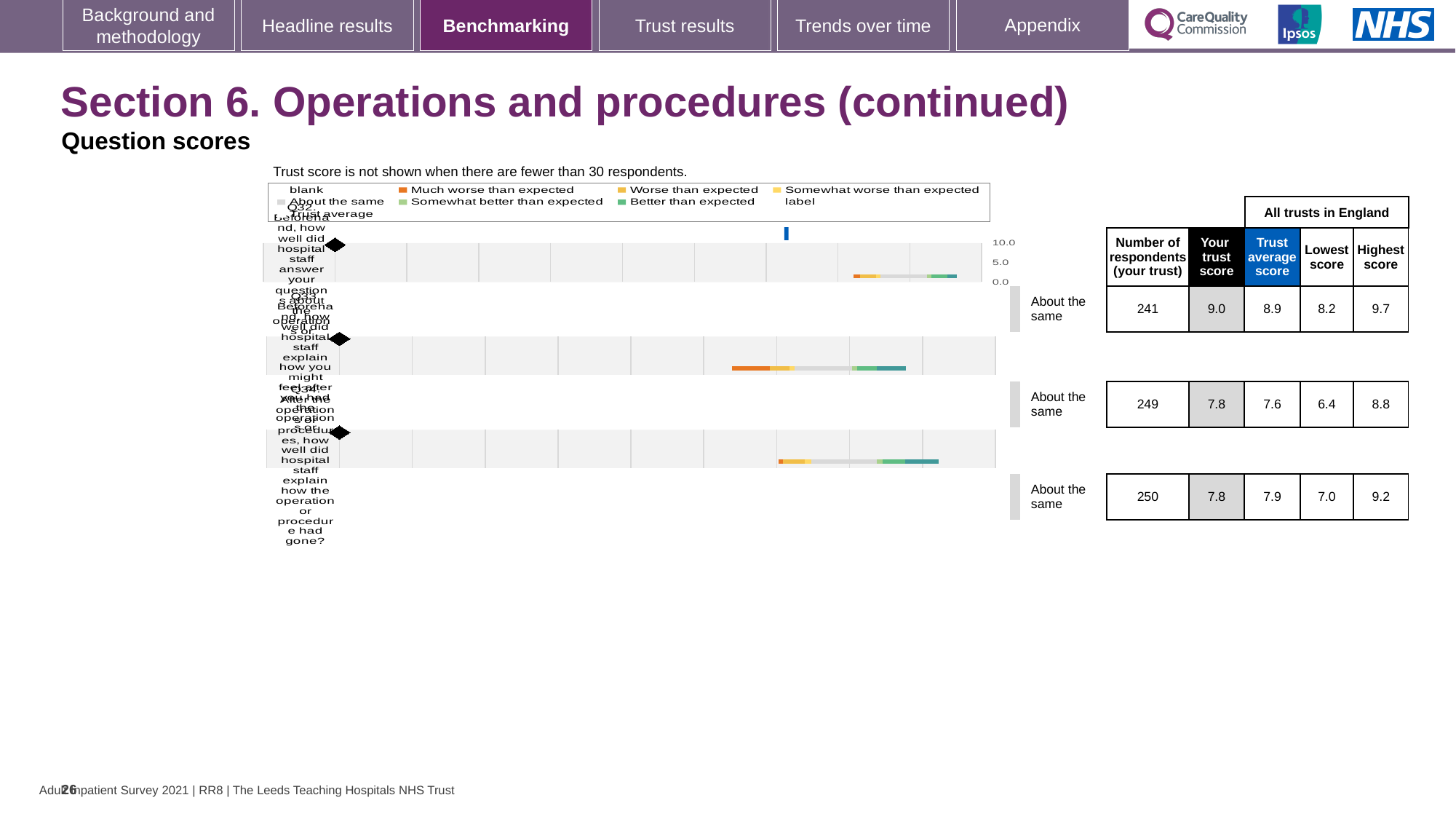
How many question charts are shown on the slide? 3 What kind of chart is used to show the question scores on this slide? bar chart In the table, what is the difference between the highest score and the lowest score for the first question row? 1.5 What benchmark category label is shown next to each of the three question rows? About the same In the table, which question row has the lowest 'Lowest score' value? the second row (6.4) What is the maximum value shown on the horizontal axis of the top chart? 10.0 In the table, what is the highest score for the third question row? 9.2 In the table, what is your trust score for the first question row? 9.0 Which legend entry is shown in orange in the chart legend? Much worse than expected In the table, is your trust score for the third question row larger or smaller than the trust average score? smaller In the table, what is the trust average score for the second question row? 7.6 In the table, what is the number of respondents for the first question row? 241